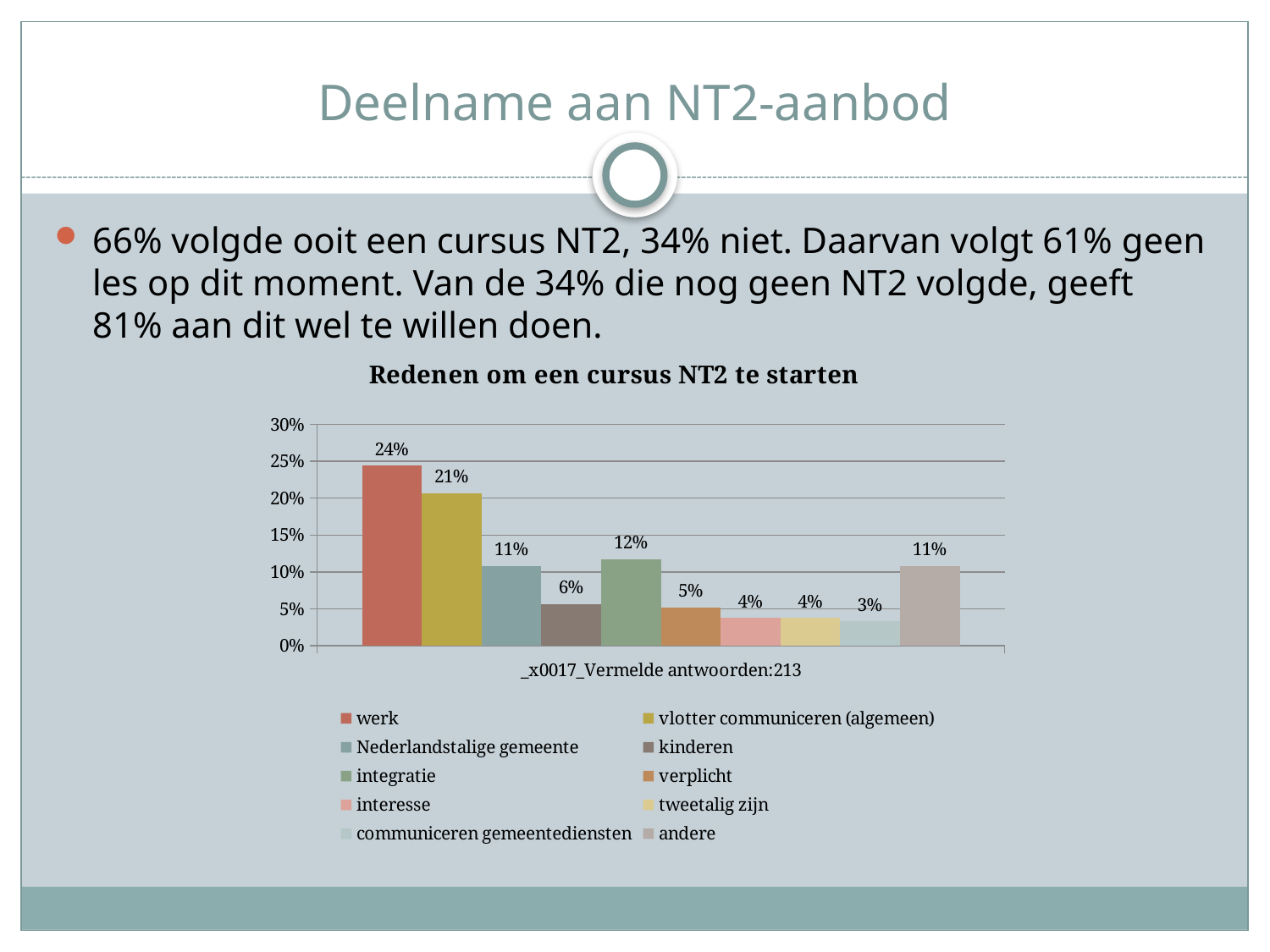
What kind of chart is shown on the slide? bar chart How many entries does the legend of the chart list? 10 What is the title of the chart on the slide? Redenen om een cursus NT2 te starten Which is larger: the value for 'integratie' or the value for 'Nederlandstalige gemeente'? integratie What is the value for 'kinderen' in the chart? 6% Which reason has the lowest value in the chart? communiceren gemeentediensten How many bars are plotted in the chart? 10 What is the value for 'andere' in the chart? 11% Which reason has the highest value in the chart? werk What is the value for 'integratie' in the chart? 12% What is the difference between the values for 'werk' and 'vlotter communiceren (algemeen)'? 3% What is the value for 'werk' in the chart 'Redenen om een cursus NT2 te starten'? 24%